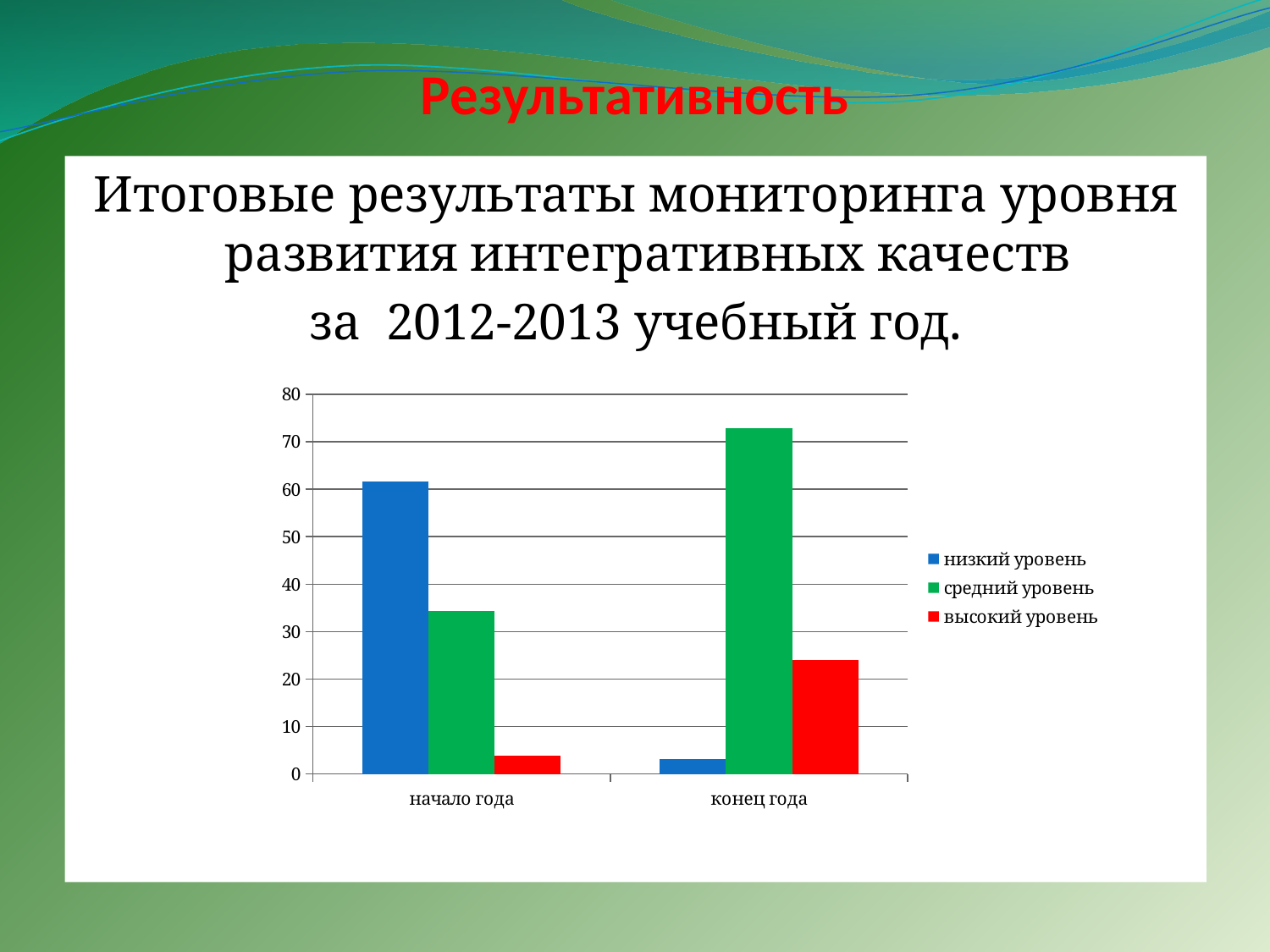
How many series does the chart legend list? 3 Is the value for низкий уровень at начало года greater or less than 60? greater Is the value for средний уровень at конец года greater or less than 70? greater Is the value for средний уровень at начало года greater or less than 30? greater Which is larger: высокий уровень at начало года or высокий уровень at конец года? конец года Does the value for низкий уровень rise or fall from начало года to конец года? fall How many categories are shown on the x axis of the chart? 2 Which series has the highest value at конец года? средний уровень Which series has the lowest value at начало года? высокий уровень What kind of chart is shown on the slide? bar chart